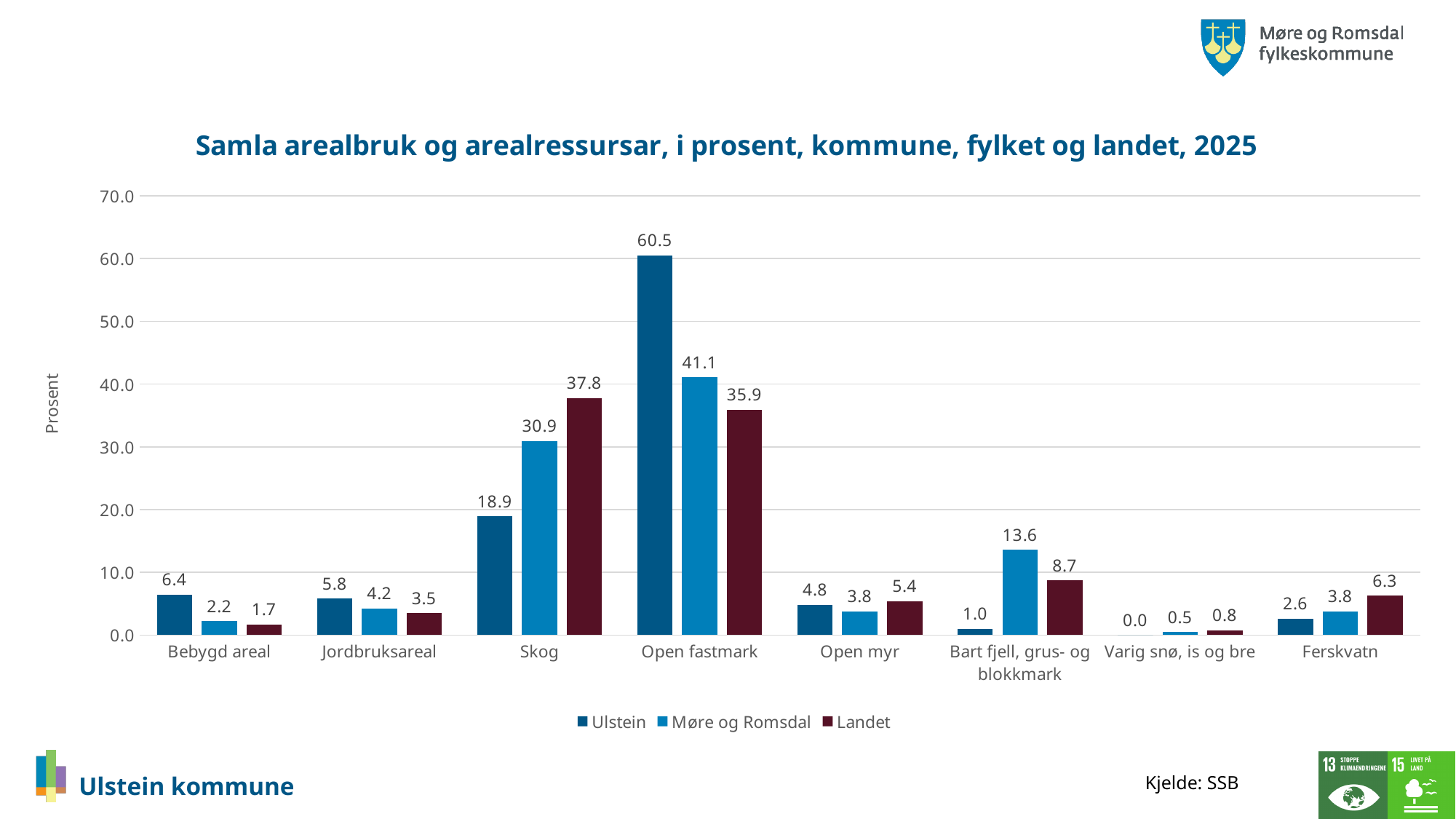
Which category has the lowest value for Landet? Varig snø, is og bre What is the difference between the Ulstein and Landet values for Open fastmark? 24.6 What is the value for Ulstein in the Open fastmark category? 60.5 What kind of chart is shown on the slide? Bar chart Which is larger for Skog: the value for Ulstein or the value for Møre og Romsdal? Møre og Romsdal How many categories are shown on the x axis? 8 What is the value for Møre og Romsdal in the Bart fjell, grus- og blokkmark category? 13.6 Which category has the highest value for Ulstein? Open fastmark How many series does the legend list? 3 What is the label of the y axis? Prosent What is the value for Landet in the Skog category? 37.8 Is the value for Møre og Romsdal in Open fastmark greater or less than 40.0? greater